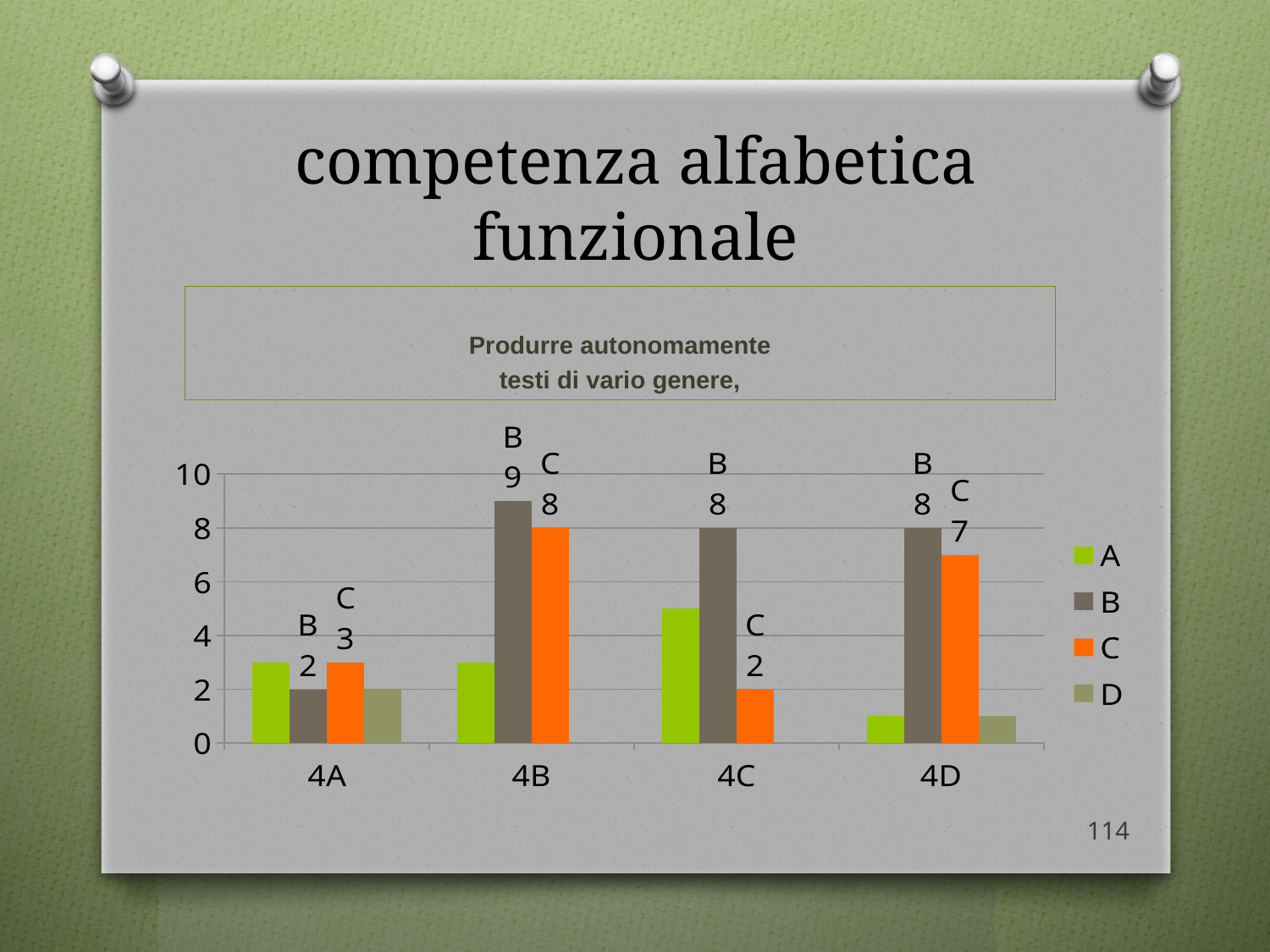
Which category has the highest value for series B? 4B For category 4D, which is larger: series B or series C? B Which category has the lowest value for series C? 4C Which series is shown in orange in the legend? C What is the value of series C for category 4D? 7 What kind of chart is shown on the slide? bar chart How many categories are shown on the x axis? 4 What is the difference between the values of series C and series B for category 4A? 1 How many series does the legend list? 4 What is the value of series B for category 4B? 9 Is the value of series A for category 4C greater or less than 4? greater What is the value of series C for category 4C? 2